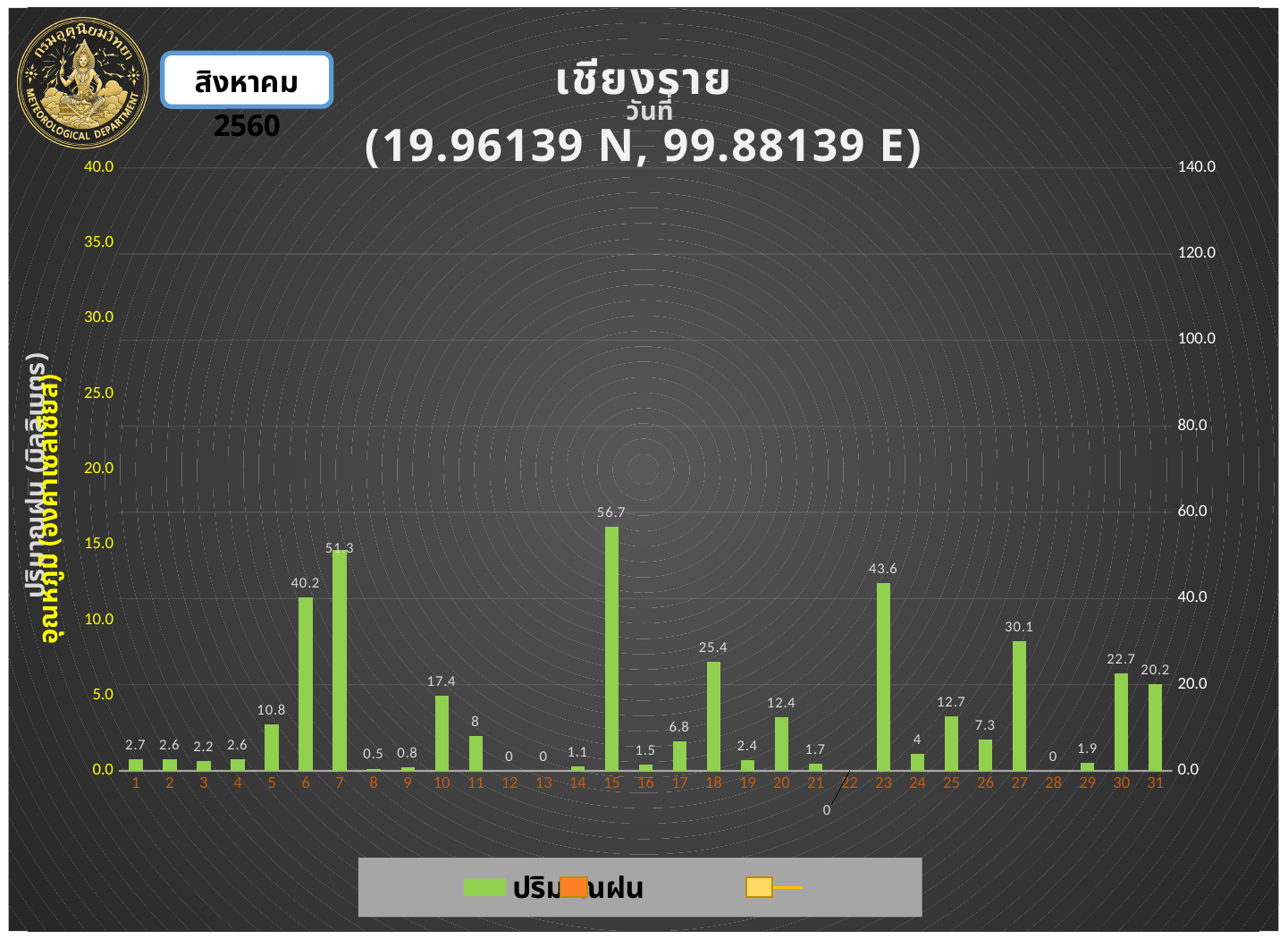
Which is larger, the rainfall value for day 18 or for day 30? day 18 What kind of chart is shown on the slide? bar chart What is the rainfall value shown for day 23? 43.6 What is the difference between the rainfall values for day 6 and day 27? 10.1 What is the rainfall value shown for day 15? 56.7 What is the difference between the rainfall values for day 15 and day 7? 5.4 What is the rainfall value shown for day 7? 51.3 Which day has the highest rainfall value on the chart? 15 What coordinates are given in the chart title? 19.96139 N, 99.88139 E How many days (categories) are shown on the x axis of the chart? 31 What is the rainfall value shown for day 28? 0 Which is larger, the rainfall value for day 10 or for day 20? day 10